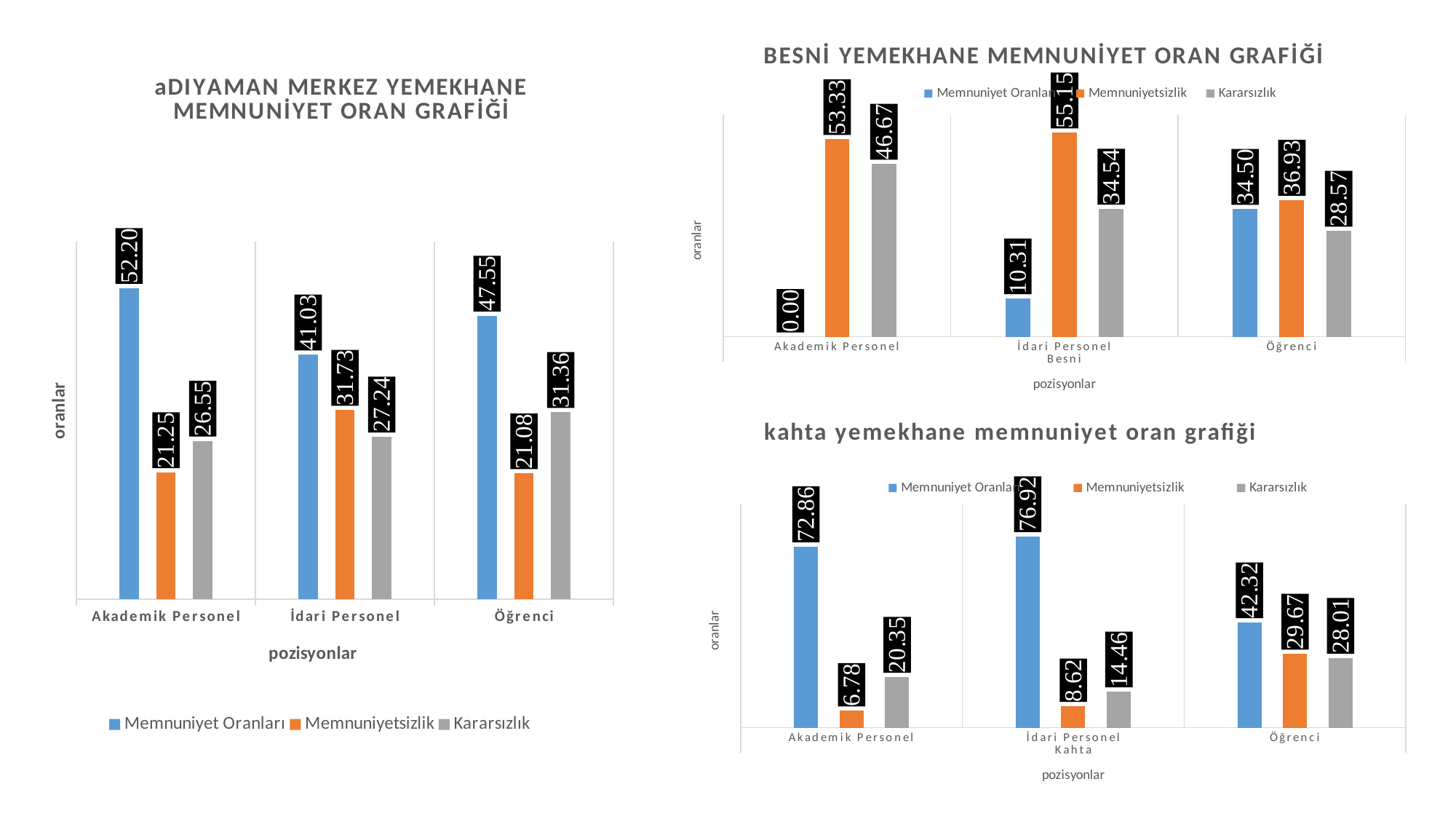
How many categories are shown on the x axis of the Besni chart? 3 In the Besni chart, which category has the highest Memnuniyetsizlik value? İdari Personel In the Besni chart, is the Kararsızlık value for Akademik Personel larger or smaller than the Kararsızlık value for Öğrenci? larger In the Adıyaman Merkez chart, what is the difference between the Memnuniyet Oranları values for Akademik Personel and İdari Personel? 11.17 How many series does the legend of the Kahta chart list? 3 In the Kahta chart, what is the difference between the Memnuniyet Oranları values for İdari Personel Kahta and Öğrenci? 34.60 In the Kahta chart, which category has the lowest Memnuniyetsizlik value? Akademik Personel In the Adıyaman Merkez chart, what is the Memnuniyet Oranları value for Akademik Personel? 52.20 In the Adıyaman Merkez chart, which category has the highest Memnuniyetsizlik value? İdari Personel In the Besni chart, what is the Memnuniyet Oranları value for Akademik Personel? 0.00 What kind of chart is the Adıyaman Merkez chart? Bar chart In the Kahta chart, what is the Memnuniyet Oranları value for İdari Personel Kahta? 76.92